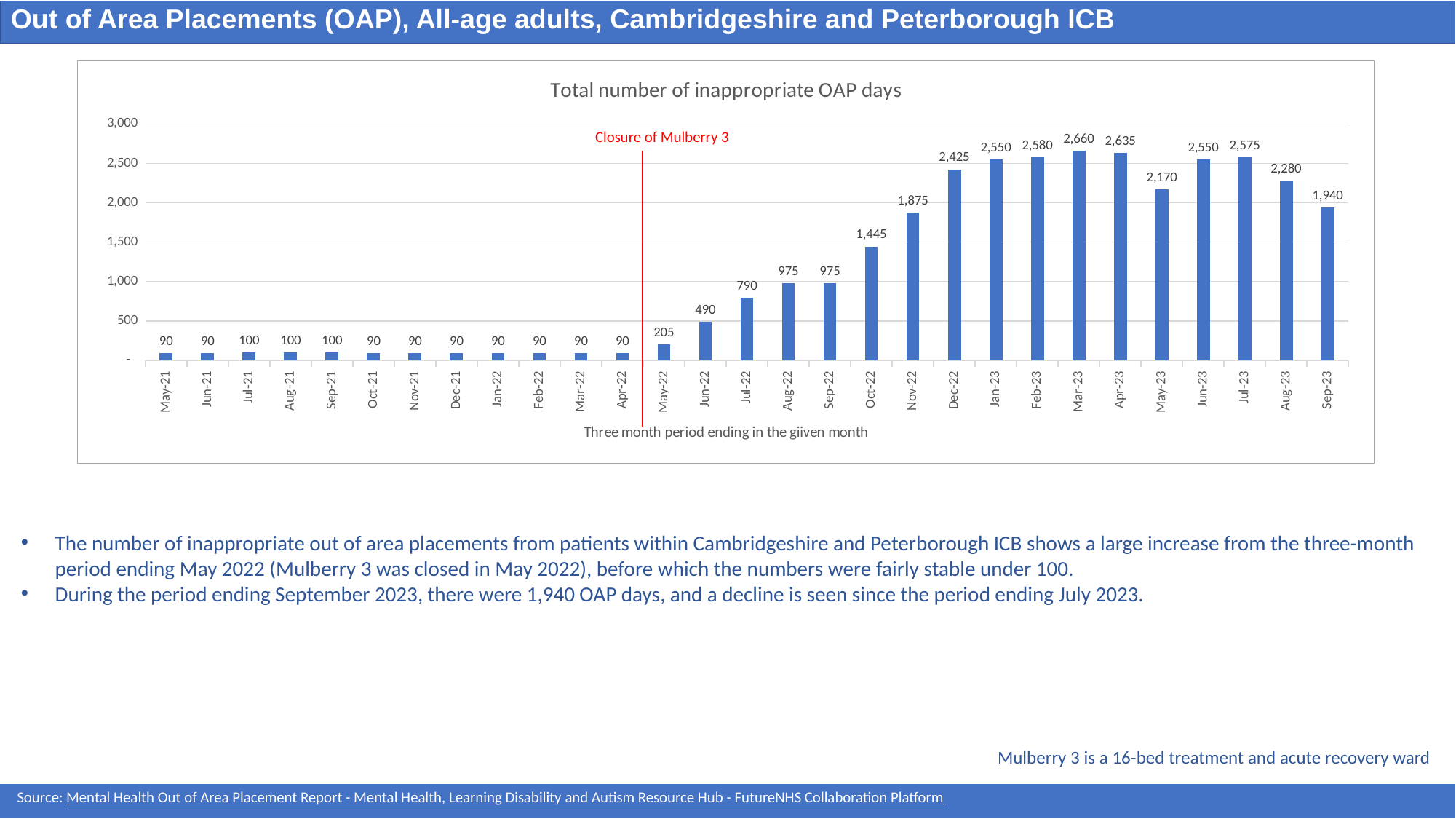
What is the lowest value shown on the chart? 90 Which is larger, the value for Jul-23 or the value for Jun-23? Jul-23 What is the difference between the values for Nov-22 and Dec-22? 550 How many months (bars) are shown on the chart? 29 What value is shown for Oct-22? 1,445 What is the total number of inappropriate OAP days for the period ending Sep-23? 1,940 What type of chart is used to show the total number of inappropriate OAP days? Bar chart Is the value for May-23 greater or less than 2,000? greater What is the difference between the values for Aug-23 and Sep-23? 340 Which month has the highest number of inappropriate OAP days? Mar-23 What event does the red vertical line on the chart mark? Closure of Mulberry 3 What value is shown for May-22, the first bar after the closure of Mulberry 3? 205